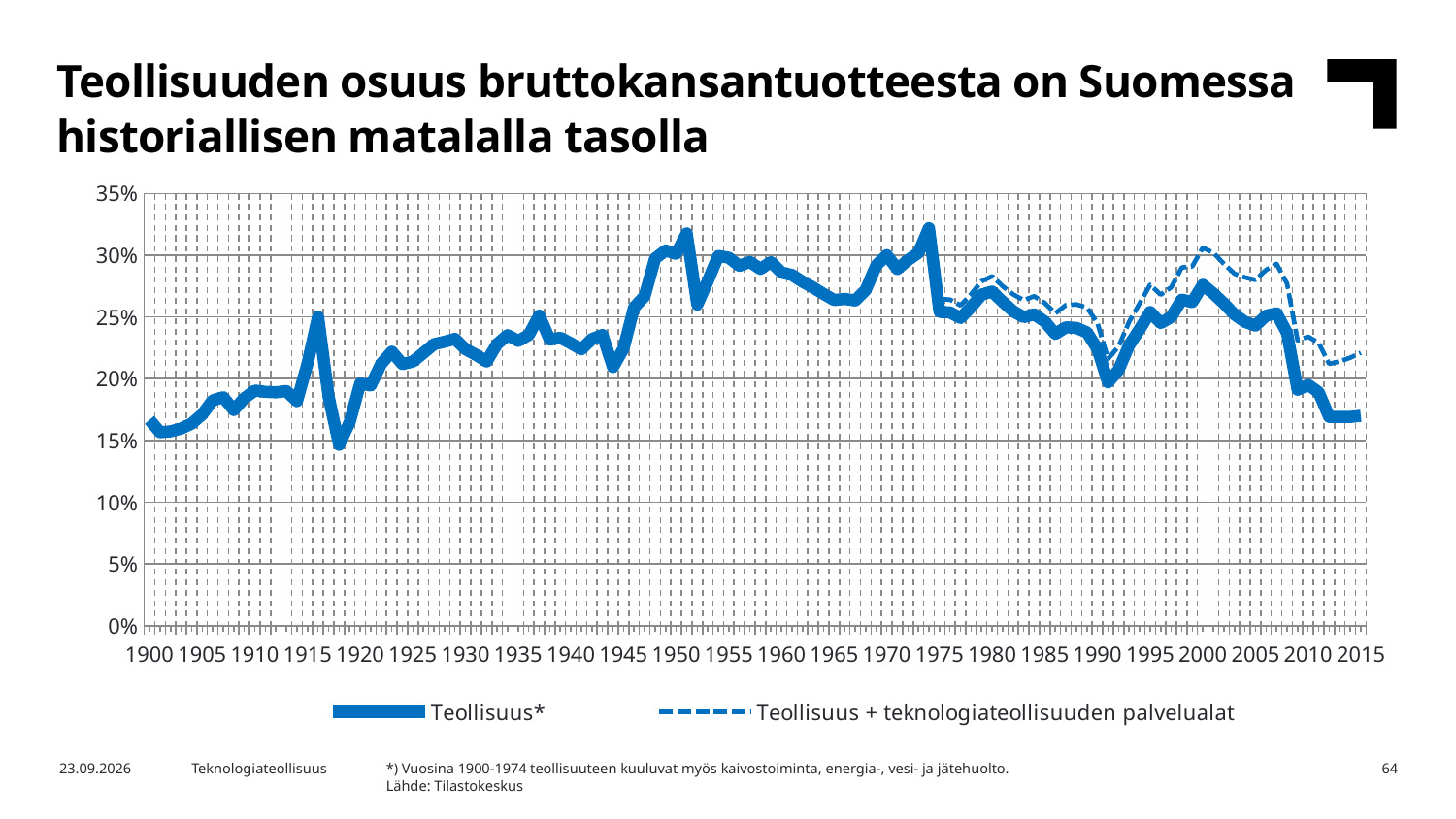
Which series is drawn with a dashed line? Teollisuus + teknologiateollisuuden palvelualat Is the value for Teollisuus* in 1951 greater or less than 30%? greater Does the Teollisuus* series rise or fall between 2008 and 2012? fall What kind of chart is shown on the slide? line chart Is the value for Teollisuus* in 1900 greater or less than 20%? less Is the value for Teollisuus + teknologiateollisuuden palvelualat in 2000 greater or less than 25%? greater In 2015, which series has the higher value, Teollisuus* or Teollisuus + teknologiateollisuuden palvelualat? Teollisuus + teknologiateollisuuden palvelualat What is the first year shown on the x axis? 1900 How many series does the legend list? 2